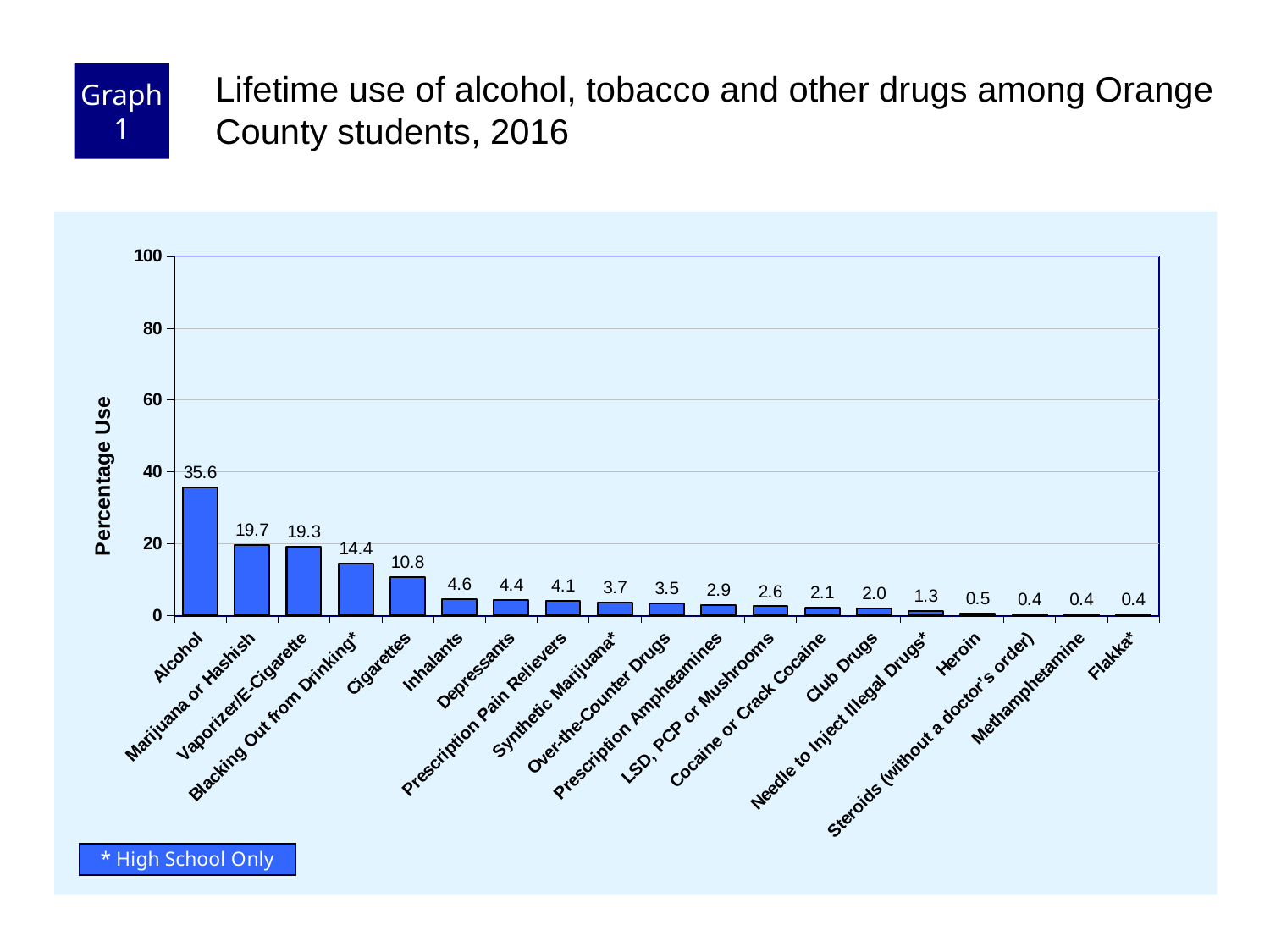
What is the percentage use for Cigarettes? 10.8 Which has a higher percentage use, Vaporizer/E-Cigarette or Cigarettes? Vaporizer/E-Cigarette What is the label of the y axis? Percentage Use How many categories are shown on the x axis? 19 What is the difference in percentage use between Alcohol and Marijuana or Hashish? 15.9 What kind of chart is shown on the slide? bar chart What is the difference in percentage use between Cigarettes and Inhalants? 6.2 Is the value for Alcohol greater or less than 40? less What is the percentage use for Blacking Out from Drinking? 14.4 What is the percentage use for Alcohol? 35.6 Which category has the highest percentage use? Alcohol What is the percentage use for Heroin? 0.5